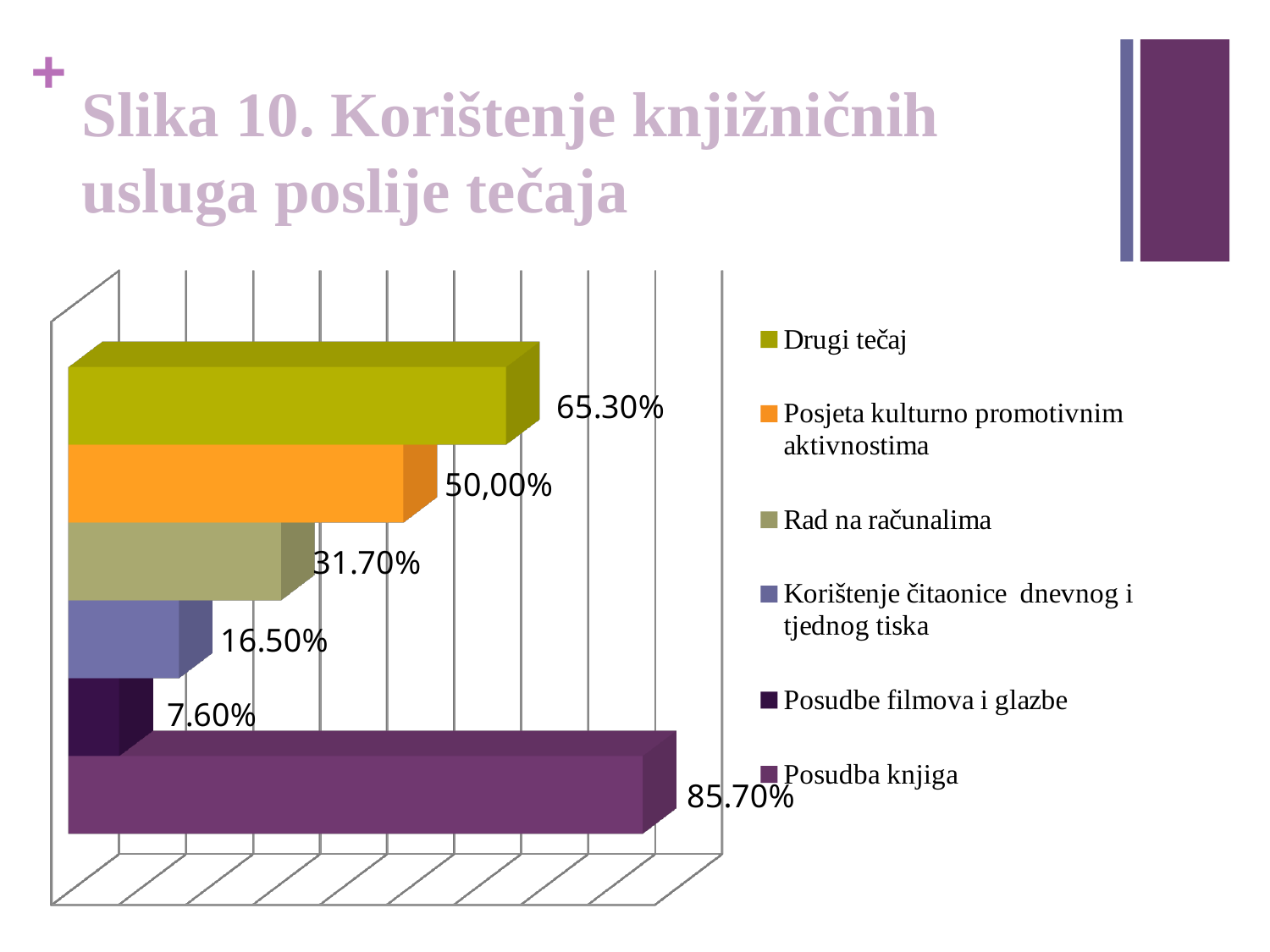
What kind of chart is shown on the slide? Bar chart What is the value for Posudba knjiga? 85.70% What is the difference between the values for Korištenje čitaonice dnevnog i tjednog tiska and Posudbe filmova i glazbe? 8.90% What is the value for Posudbe filmova i glazbe? 7.60% What is the difference between the values for Posudba knjiga and Drugi tečaj? 20.40% Which is larger, the value for Rad na računalima or the value for Korištenje čitaonice dnevnog i tjednog tiska? Rad na računalima Which category has the lowest value? Posudbe filmova i glazbe Which category has the highest value? Posudba knjiga How many entries does the legend list? 6 What is the value for Posjeta kulturno promotivnim aktivnostima? 50,00% What is the value for Drugi tečaj? 65.30% What is the value for Rad na računalima? 31.70%